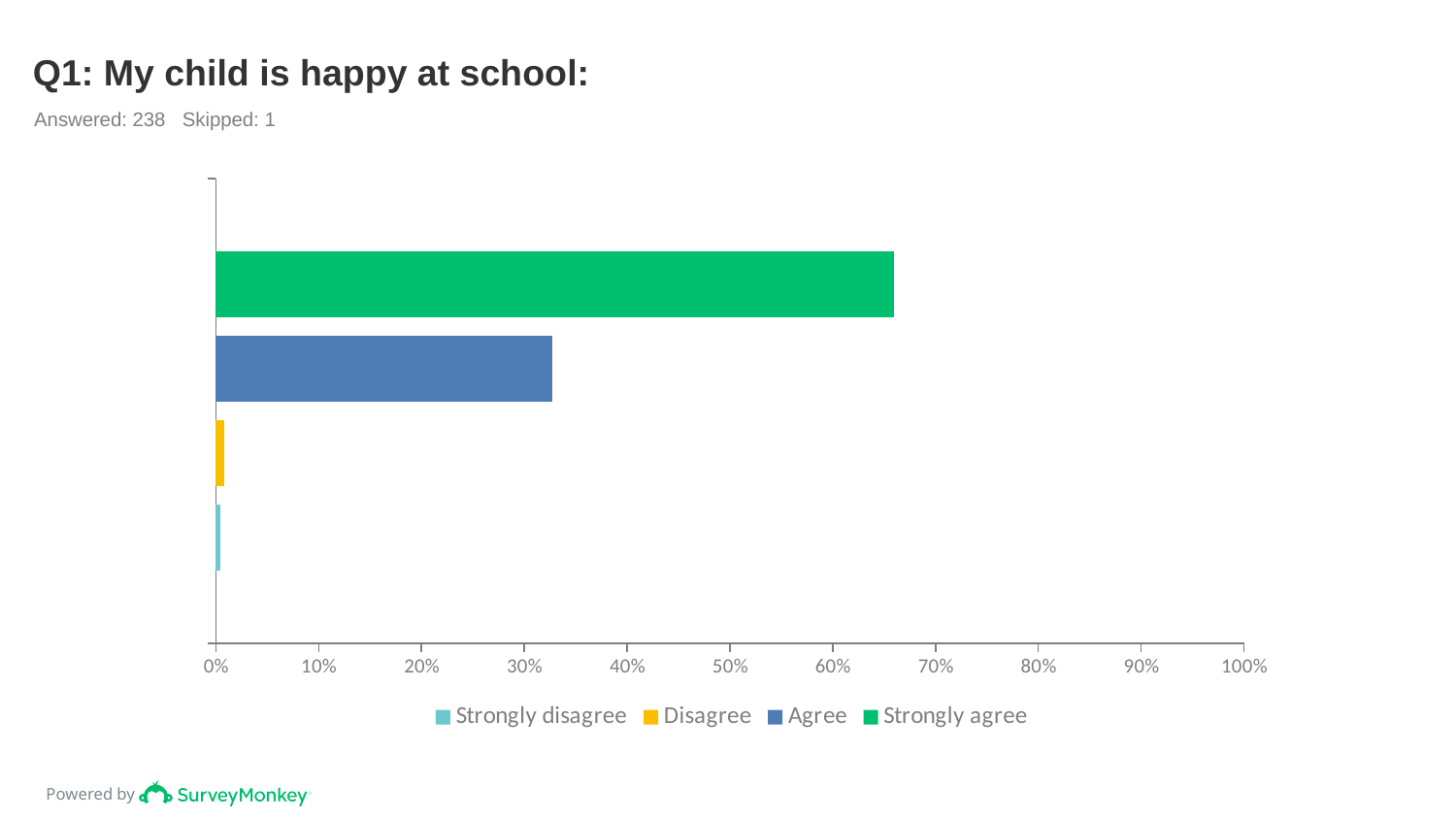
How many series does the legend list? 4 Is the value for Strongly agree greater or less than 70%? less Is the value for Disagree greater or less than 10%? less How many bars are plotted in the chart? 4 Is the value for Agree greater or less than 30%? greater What is the title of the chart? Q1: My child is happy at school: Which is larger, the value for Agree or the value for Disagree? Agree Which response has the highest value? Strongly agree Which is larger, the value for Agree or the value for Strongly agree? Strongly agree What kind of chart is shown on the slide? bar chart